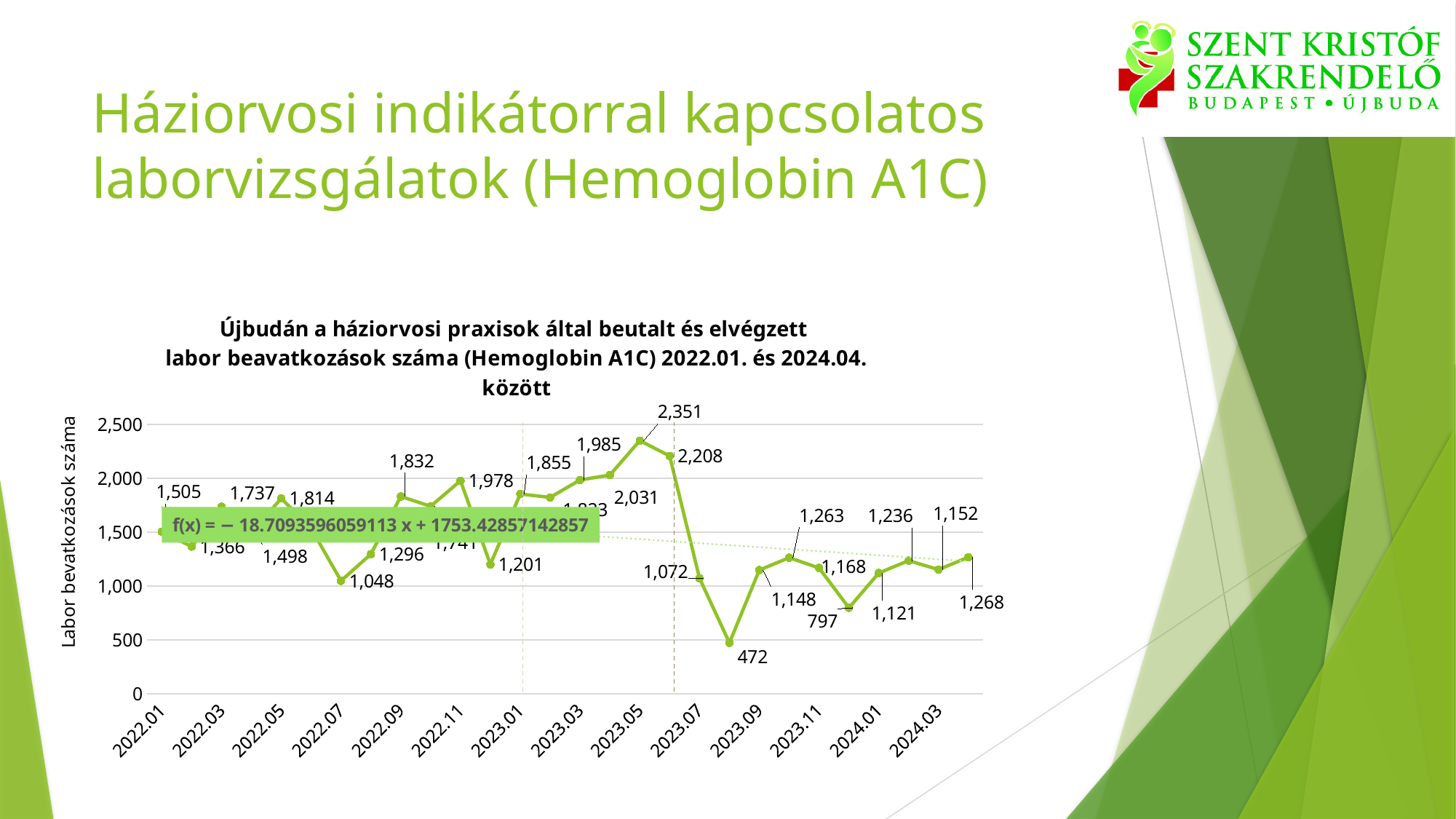
Does the dotted trendline rise or fall from left to right? fall Which is larger, the value for 2022.11 or the value for 2023.01? 2022.11 Is the value for 2023.08 greater or less than 500? less What is the value for 2023.05? 2,351 What is the lowest value plotted on the chart? 472 What kind of chart is shown on the slide? line chart What is the value for 2023.11? 1,168 What is the label of the vertical axis? Labor bevatkozások száma What is the value for 2022.07? 1,048 What is the difference between the highest value (2,351) and the lowest value (472)? 1,879 Which month has the highest value? 2023.05 What is the value for 2022.01? 1,505